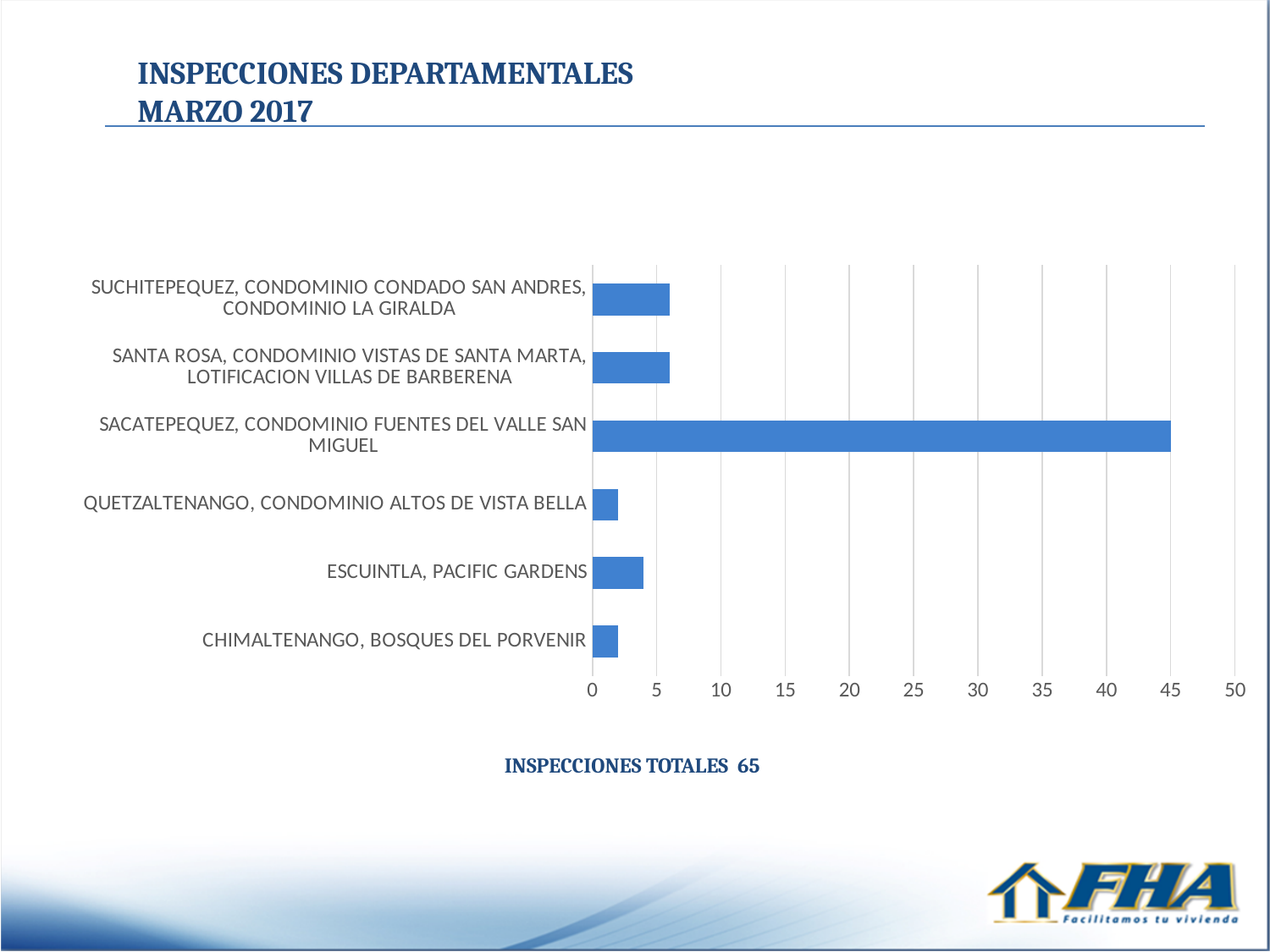
What total number of inspections is stated below the chart? 65 Is the value for CHIMALTENANGO, BOSQUES DEL PORVENIR greater or less than 5? less Is the value for SACATEPEQUEZ, CONDOMINIO FUENTES DEL VALLE SAN MIGUEL greater or less than 40? greater Which is larger, the value for ESCUINTLA, PACIFIC GARDENS or the value for CHIMALTENANGO, BOSQUES DEL PORVENIR? ESCUINTLA, PACIFIC GARDENS How many categories are plotted in the chart? 6 What is the value for SACATEPEQUEZ, CONDOMINIO FUENTES DEL VALLE SAN MIGUEL? 45 Is the value for SUCHITEPEQUEZ, CONDOMINIO CONDADO SAN ANDRES, CONDOMINIO LA GIRALDA greater or less than 5? greater Which is larger, the value for SACATEPEQUEZ, CONDOMINIO FUENTES DEL VALLE SAN MIGUEL or the value for SANTA ROSA, CONDOMINIO VISTAS DE SANTA MARTA, LOTIFICACION VILLAS DE BARBERENA? SACATEPEQUEZ, CONDOMINIO FUENTES DEL VALLE SAN MIGUEL Which category has the highest value in the chart? SACATEPEQUEZ, CONDOMINIO FUENTES DEL VALLE SAN MIGUEL What is the title of the slide containing the chart? INSPECCIONES DEPARTAMENTALES MARZO 2017 What kind of chart is shown on the slide? bar chart